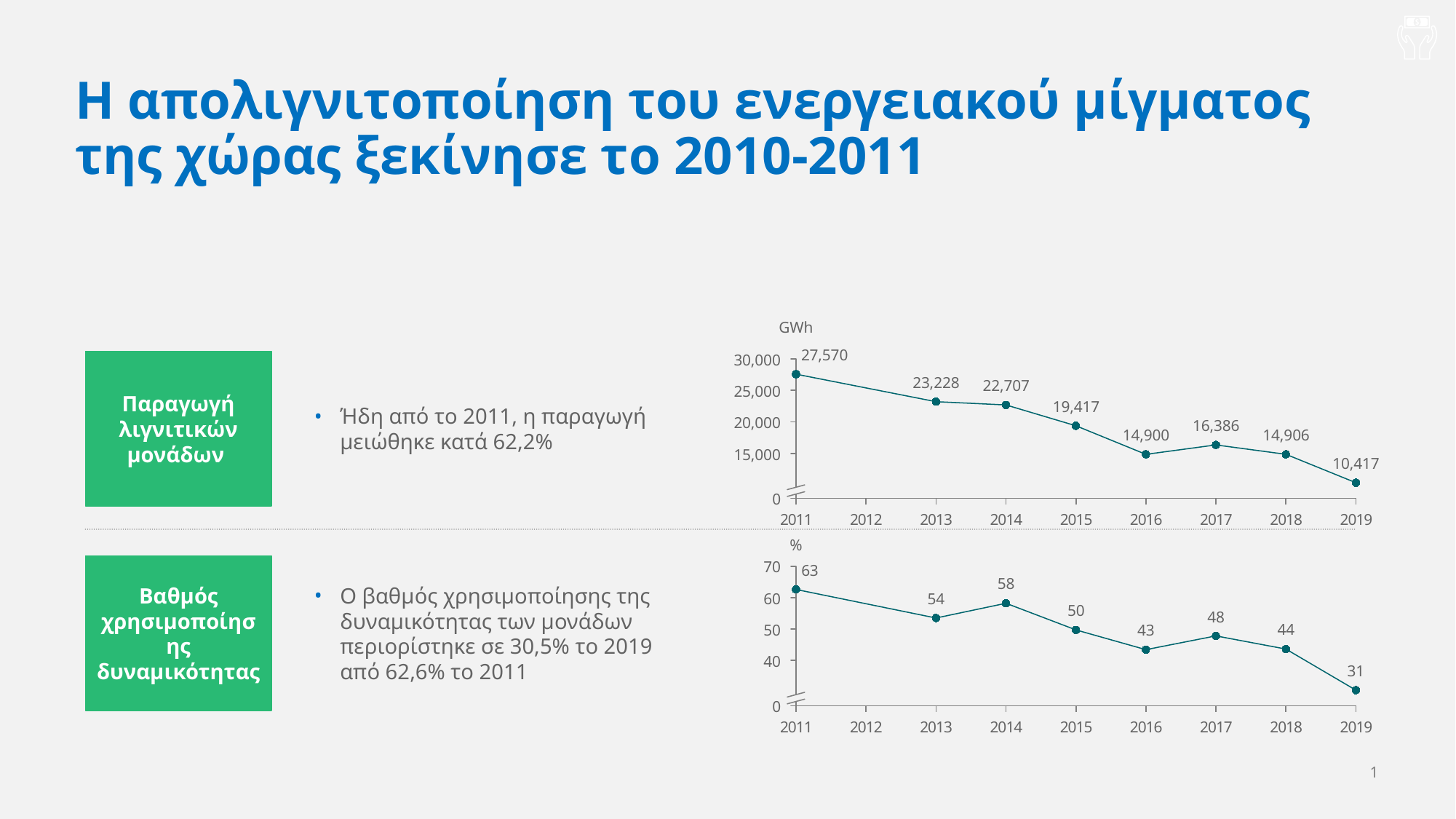
In the top chart (GWh), what is the difference between the 2011 value and the 2019 value? 17,153 In the top chart (GWh), what is the value for 2017? 16,386 In the top chart (GWh), what is the value for 2019? 10,417 In the bottom chart (%), do the values generally rise or fall from 2011 to 2019? Fall What kind of chart is the bottom chart (%)? Line chart How many years are labelled on the x axis of the top chart (GWh)? 9 In the top chart (GWh), which is larger, the value for 2016 or the value for 2017? 2017 In the top chart (GWh), what is the value for 2011? 27,570 In the bottom chart (%), which year has the highest value? 2011 In the bottom chart (%), what is the difference between the 2011 value and the 2019 value? 32 In the bottom chart (%), what is the value for 2014? 58 In the top chart (GWh), which year has the lowest value? 2019